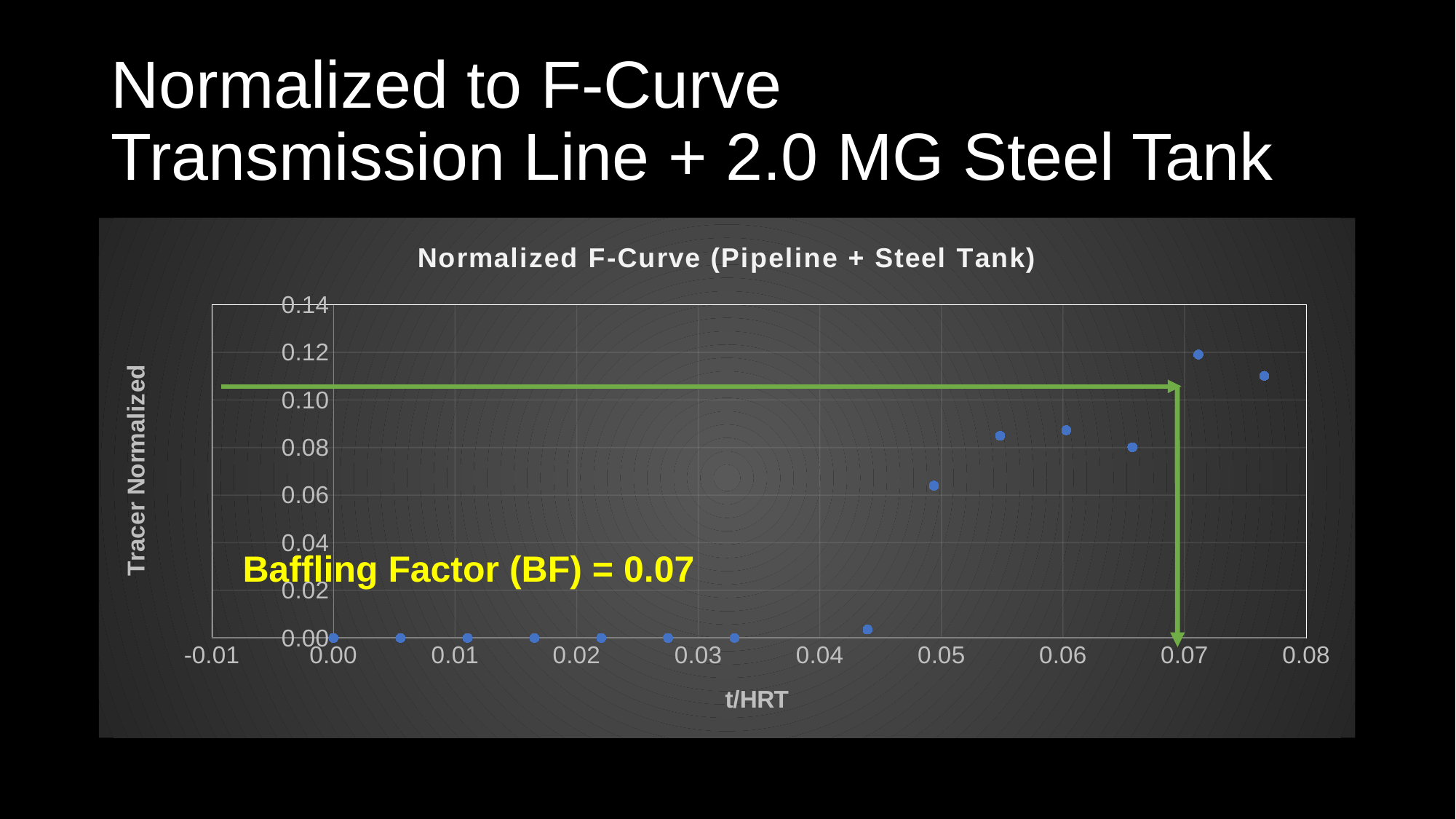
Which of the two points is higher: the one near t/HRT = 0.07 or the one near t/HRT = 0.05? the one near t/HRT = 0.07 Do the plotted values generally rise or fall as t/HRT increases from 0.04 to 0.07? rise What Baffling Factor (BF) value is annotated on the chart? 0.07 What is the title of the chart? Normalized F-Curve (Pipeline + Steel Tank) What is the label of the x axis? t/HRT How many data points are plotted on the chart? 14 Is the value of the point plotted near t/HRT = 0.07 greater or less than 0.10? greater What is the highest tick value shown on the y axis? 0.14 Is the value of the point plotted near t/HRT = 0.044 greater or less than 0.02? less Is the value of the point plotted near t/HRT = 0.05 greater or less than 0.08? less What kind of chart is shown on the slide? Scatter chart